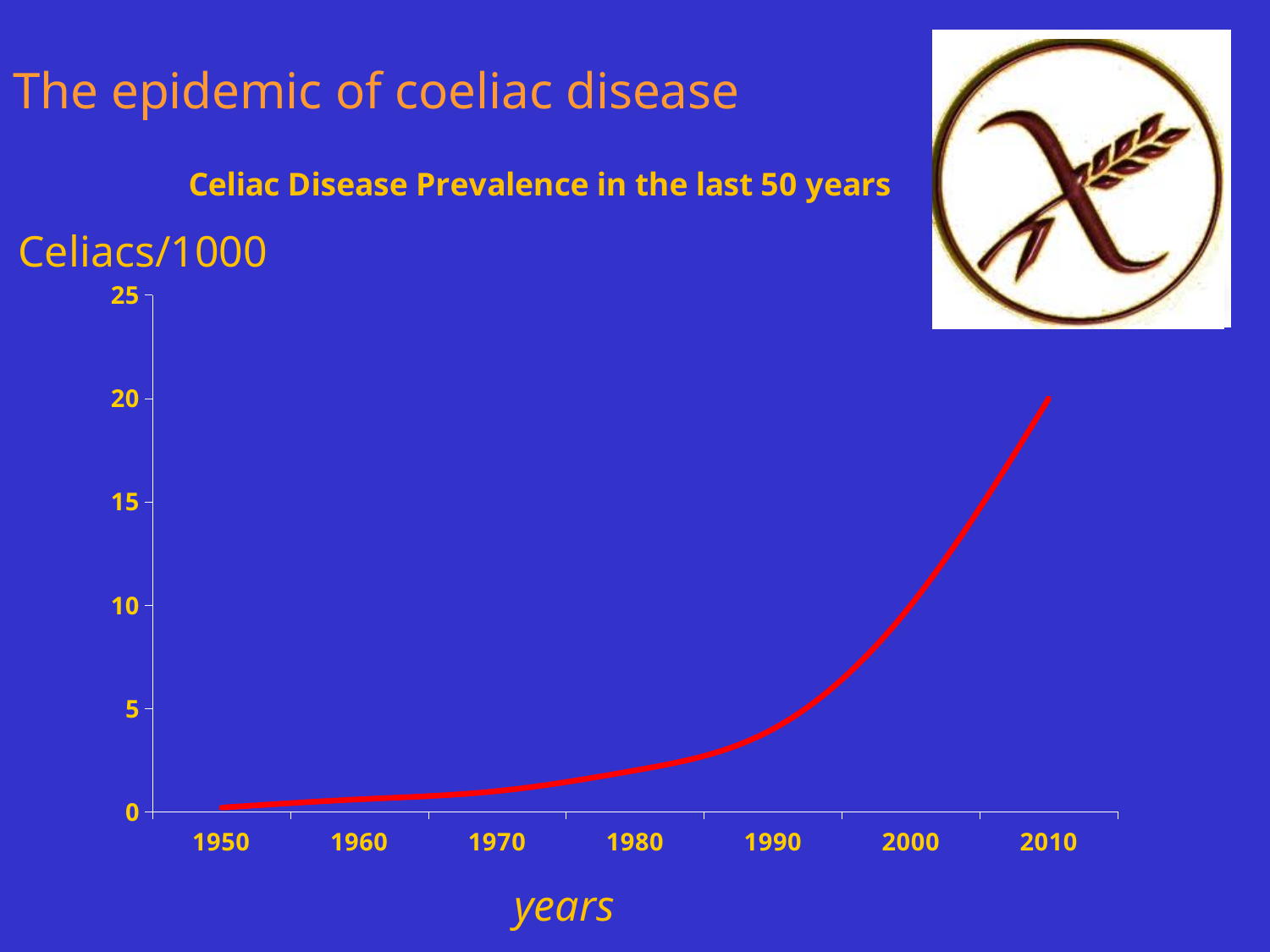
What is the label on the vertical axis of the chart? Celiacs/1000 Is the value for 2000 greater or less than 5? greater Which year on the x axis has the lowest value? 1950 What is the title of the chart? Celiac Disease Prevalence in the last 50 years Which year on the x axis has the highest value? 2010 Is the value for 1990 greater or less than 5? less Which year has the larger value, 1990 or 2000? 2000 What is the value (Celiacs/1000) in 2010? 20 What kind of chart is shown on the slide? line chart How many year labels are shown on the x axis? 7 Do the values rise or fall along the x axis from 1950 to 2010? rise